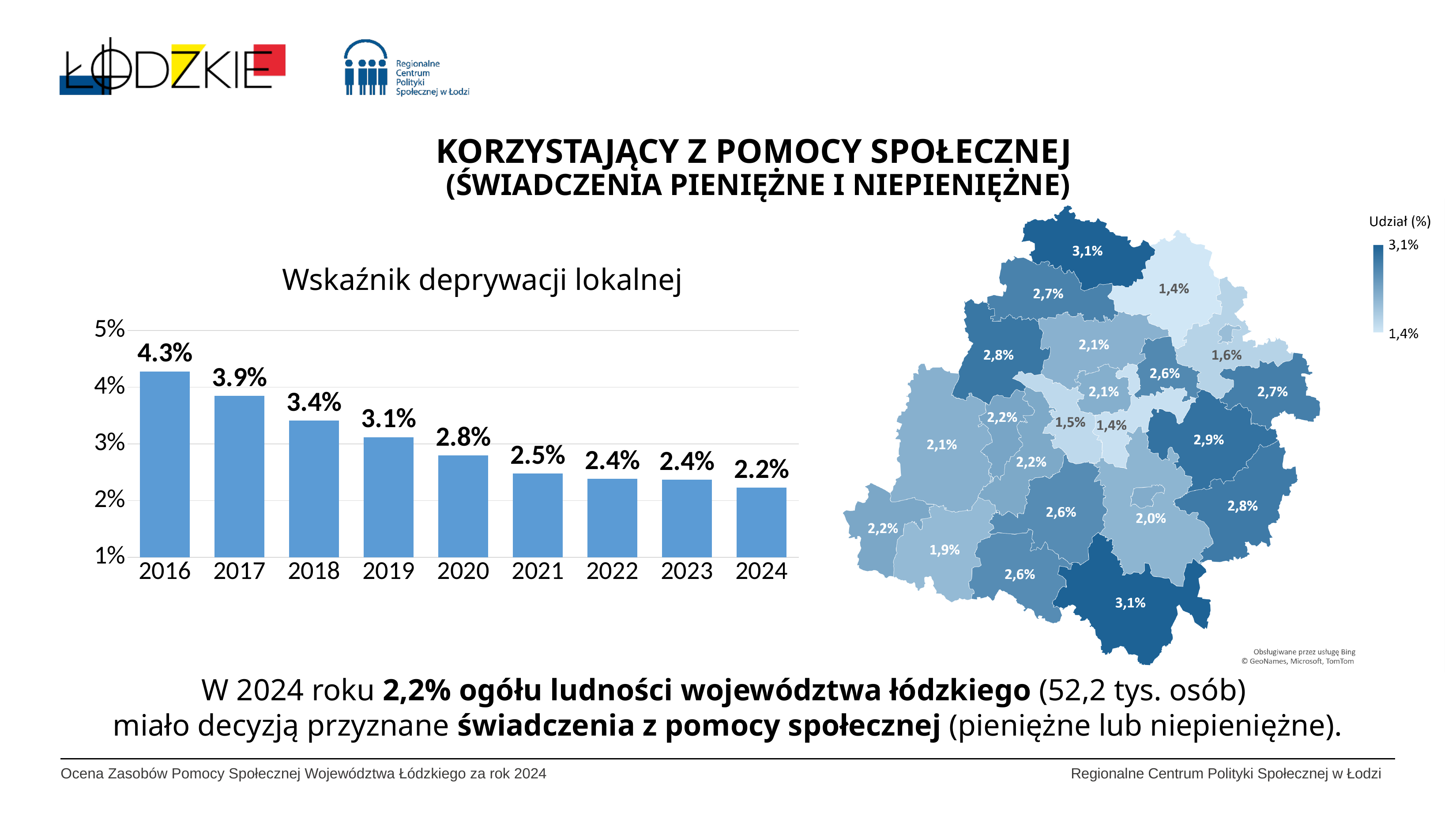
In the bar chart 'Wskaźnik deprywacji lokalnej', which year has the lowest value? 2024 In the bar chart 'Wskaźnik deprywacji lokalnej', what is the difference between the values for 2016 and 2024? 2.1% In the bar chart 'Wskaźnik deprywacji lokalnej', is the value for 2017 greater or less than 3%? greater In the bar chart 'Wskaźnik deprywacji lokalnej', what is the value for 2024? 2.2% What kind of chart is 'Wskaźnik deprywacji lokalnej'? bar chart On the map chart on the right, what is the highest value shown in the 'Udział (%)' legend? 3,1% In the bar chart 'Wskaźnik deprywacji lokalnej', which year has the highest value? 2016 In the bar chart 'Wskaźnik deprywacji lokalnej', which is larger, the value for 2018 or the value for 2021? 2018 How many years are shown in the bar chart 'Wskaźnik deprywacji lokalnej'? 9 In the bar chart 'Wskaźnik deprywacji lokalnej', what is the value for 2016? 4.3% In the bar chart 'Wskaźnik deprywacji lokalnej', what is the value for 2020? 2.8% In the bar chart 'Wskaźnik deprywacji lokalnej', do the values rise or fall from 2016 to 2024? fall